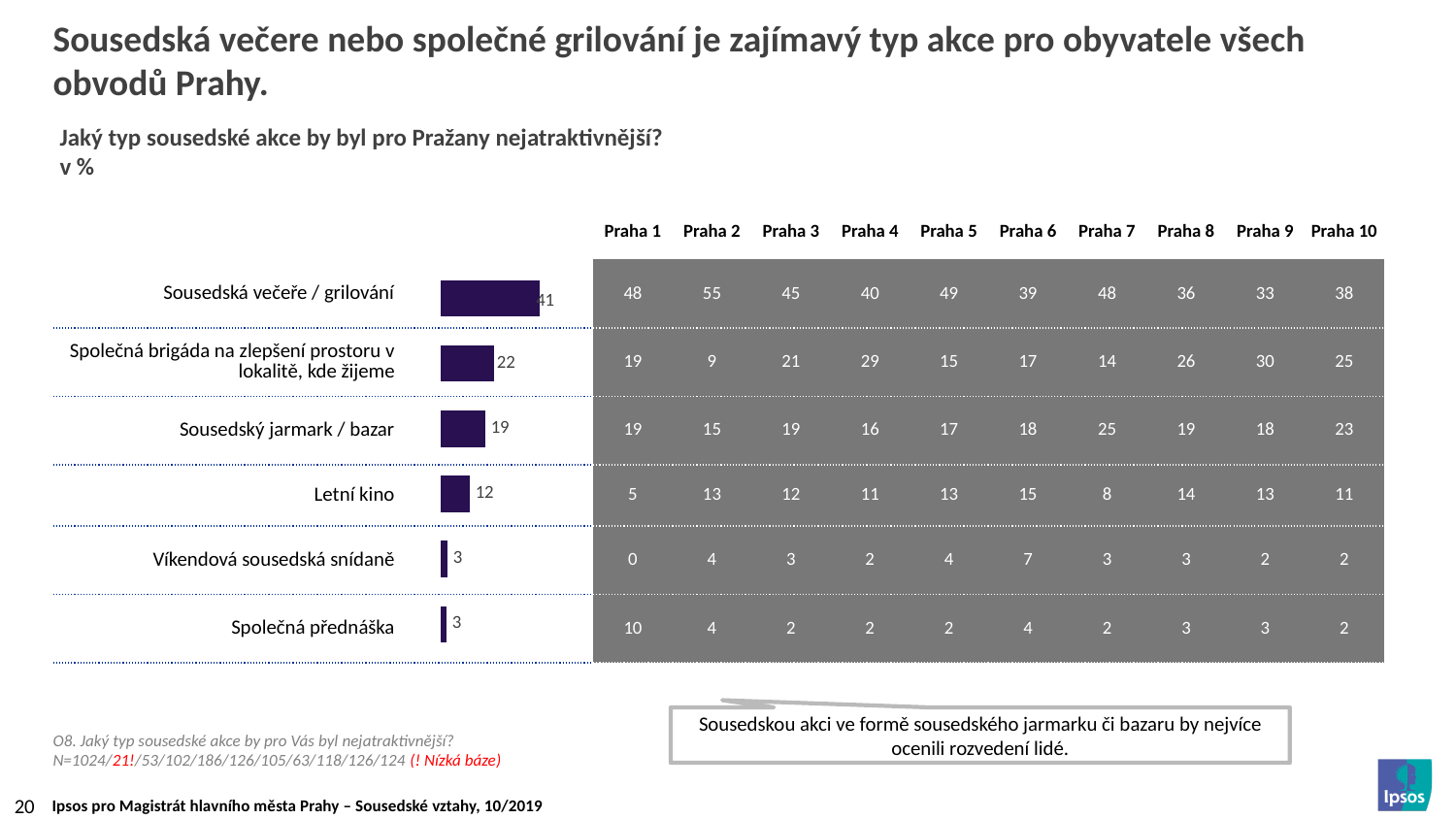
What is the value for "Sousedská večeře / grilování" in the bar chart? 41 What is the value for "Společná brigáda na zlepšení prostoru v lokalitě, kde žijeme" in the bar chart? 22 What is the value for "Víkendová sousedská snídaně" in the bar chart? 3 What is the value for "Letní kino" in the bar chart? 12 How many categories are shown in the bar chart? 6 What kind of chart is shown on the slide? Bar chart In the table next to the bar chart, what is the value for "Sousedská večeře / grilování" in Praha 2? 55 Which is larger in the bar chart: the value for "Sousedský jarmark / bazar" or the value for "Letní kino"? Sousedský jarmark / bazar In the table next to the bar chart, what is the value for "Letní kino" in Praha 1? 5 What is the difference between the values for "Sousedská večeře / grilování" and "Sousedský jarmark / bazar" in the bar chart? 22 What unit are the values in the chart expressed in, according to the subtitle? % Which category has the highest value in the bar chart? Sousedská večeře / grilování